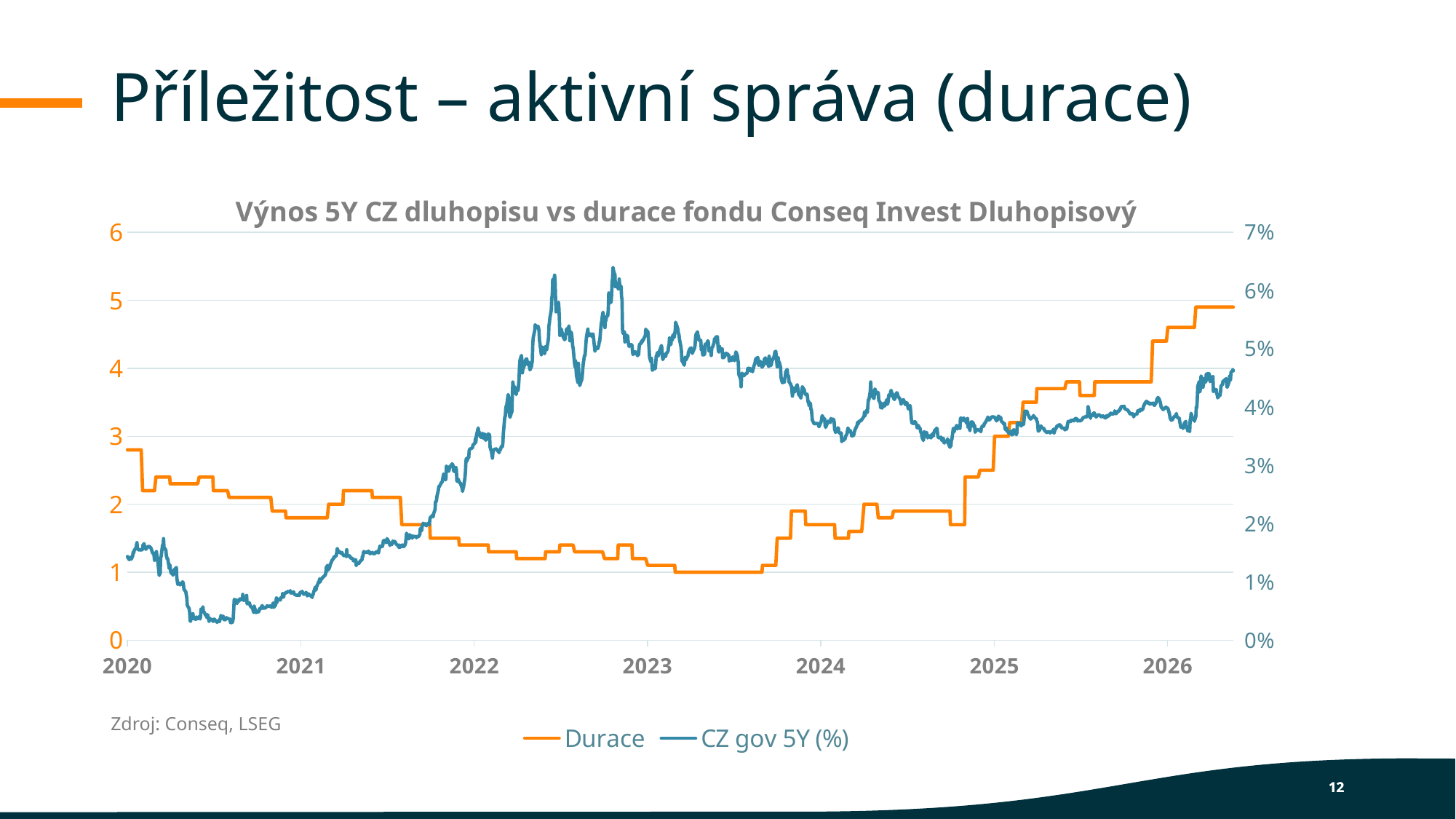
Which series is drawn in orange? Durace Is the value of the Durace line at the start of 2020 greater or less than 2? greater How many series does the chart legend list? 2 Does the Durace line rise or fall between 2025 and 2026? rise Is the value of the CZ gov 5Y (%) line in mid-2020 greater or less than 1%? less In which year does the CZ gov 5Y (%) line reach its highest point? 2022 Is the value of the Durace line during 2023 greater or less than 2? less What is the title of the chart? Výnos 5Y CZ dluhopisu vs durace fondu Conseq Invest Dluhopisový What kind of chart is shown on the slide? line chart How many year labels are shown on the x axis? 7 Is the Durace value higher at the start of 2020 or at the end of the series in 2026? 2026